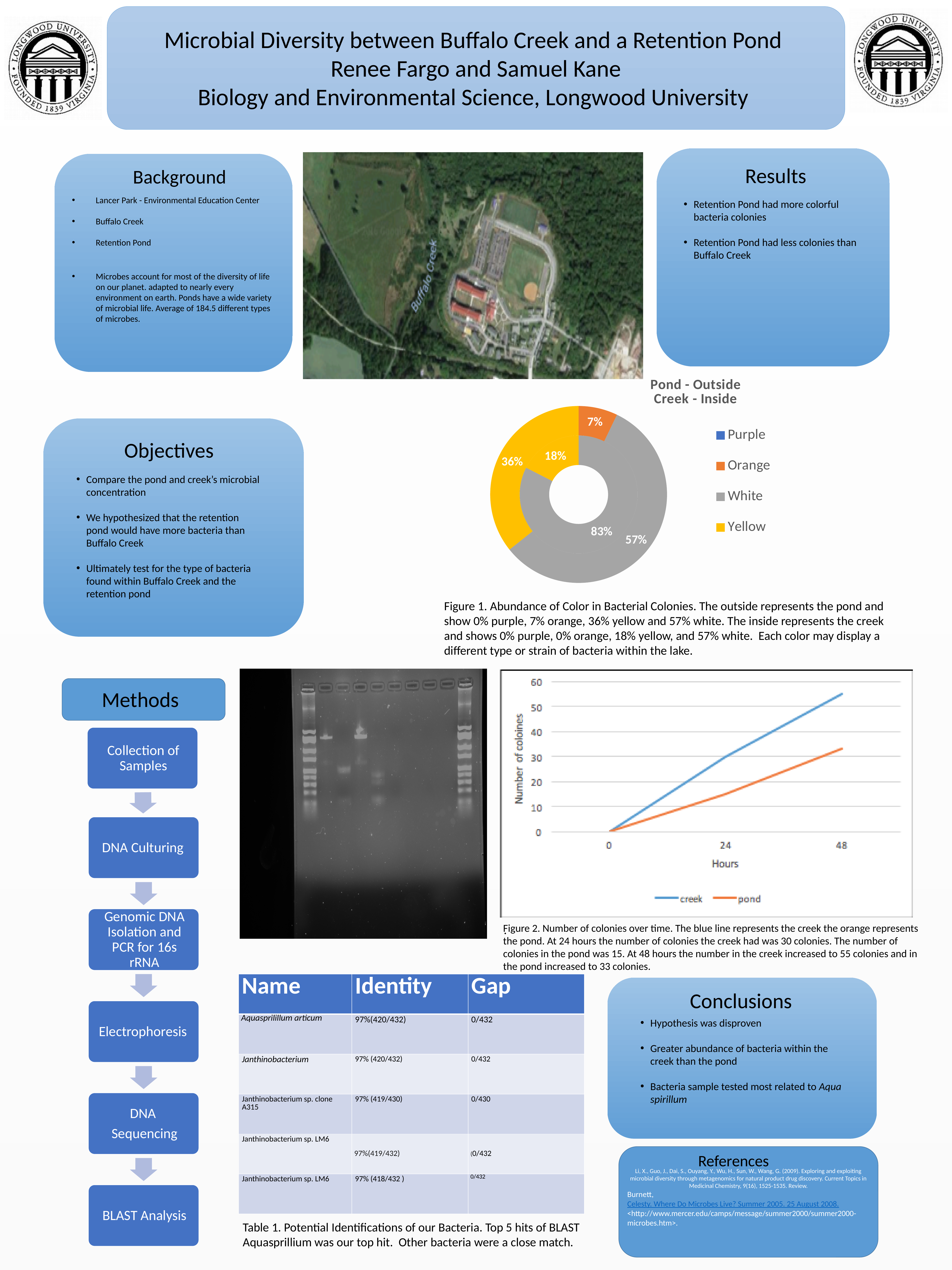
In the line chart (Figure 2), is the value for the creek at 48 hours greater or less than 50? greater What kind of chart is Figure 2, the chart of number of colonies over hours? line chart In the doughnut chart (Figure 1), what percentage does the yellow segment of the outer ring (pond) show? 36% In the doughnut chart (Figure 1), which colour has the largest share of the outer ring (pond)? White In the doughnut chart (Figure 1), what is the difference between the white share of the outer ring (57%) and the yellow share of the outer ring (36%)? 21% In the doughnut chart (Figure 1), what percentage does the yellow segment of the inner ring (creek) show? 18% In the doughnut chart (Figure 1), what percentage does the orange segment of the outer ring (pond) show? 7% In the line chart (Figure 2), which series has the higher number of colonies at 48 hours, creek or pond? creek In the line chart (Figure 2), how many series does the legend list? 2 In the doughnut chart (Figure 1), how many colour categories does the legend list? 4 What kind of chart is Figure 1, the chart showing the abundance of colour in bacterial colonies? doughnut chart In the doughnut chart (Figure 1), what percentage does the white segment of the inner ring (creek) show? 83%